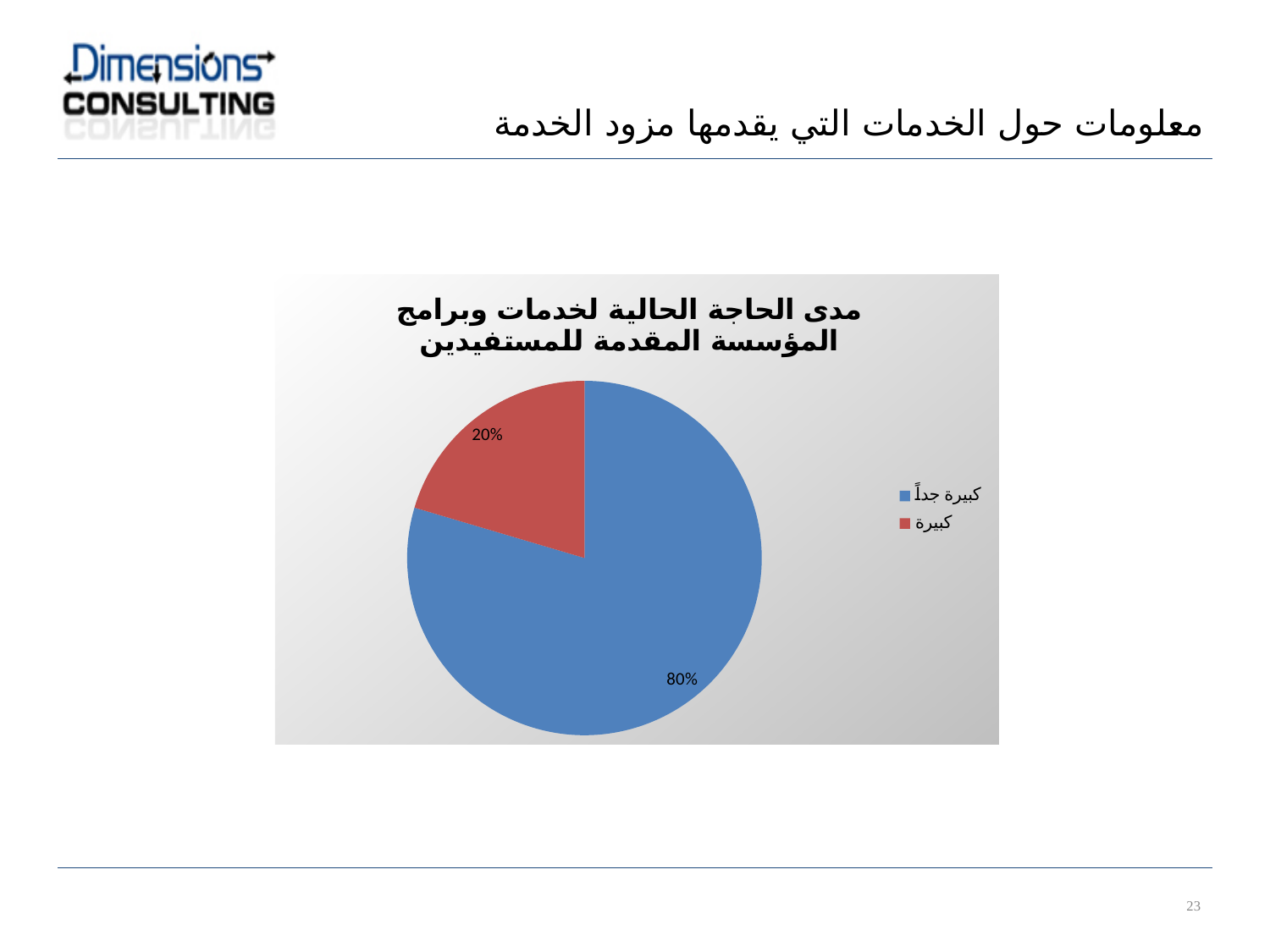
What kind of chart is shown on the slide? pie chart Which is larger, the "كبيرة جداً" slice or the "كبيرة" slice? كبيرة جداً Which category has the smallest slice of the pie? كبيرة What is the title of the pie chart? مدى الحاجة الحالية لخدمات وبرامج المؤسسة المقدمة للمستفيدين Which category has the largest slice of the pie? كبيرة جداً What share of the pie does the "كبيرة جداً" slice represent? 80% What is the difference in percentage points between the "كبيرة جداً" slice and the "كبيرة" slice? 60% What share of the pie does the "كبيرة" slice represent? 20% How many slices does the pie chart have? 2 What colour is the "كبيرة" slice in the pie chart? red How many entries does the legend list? 2